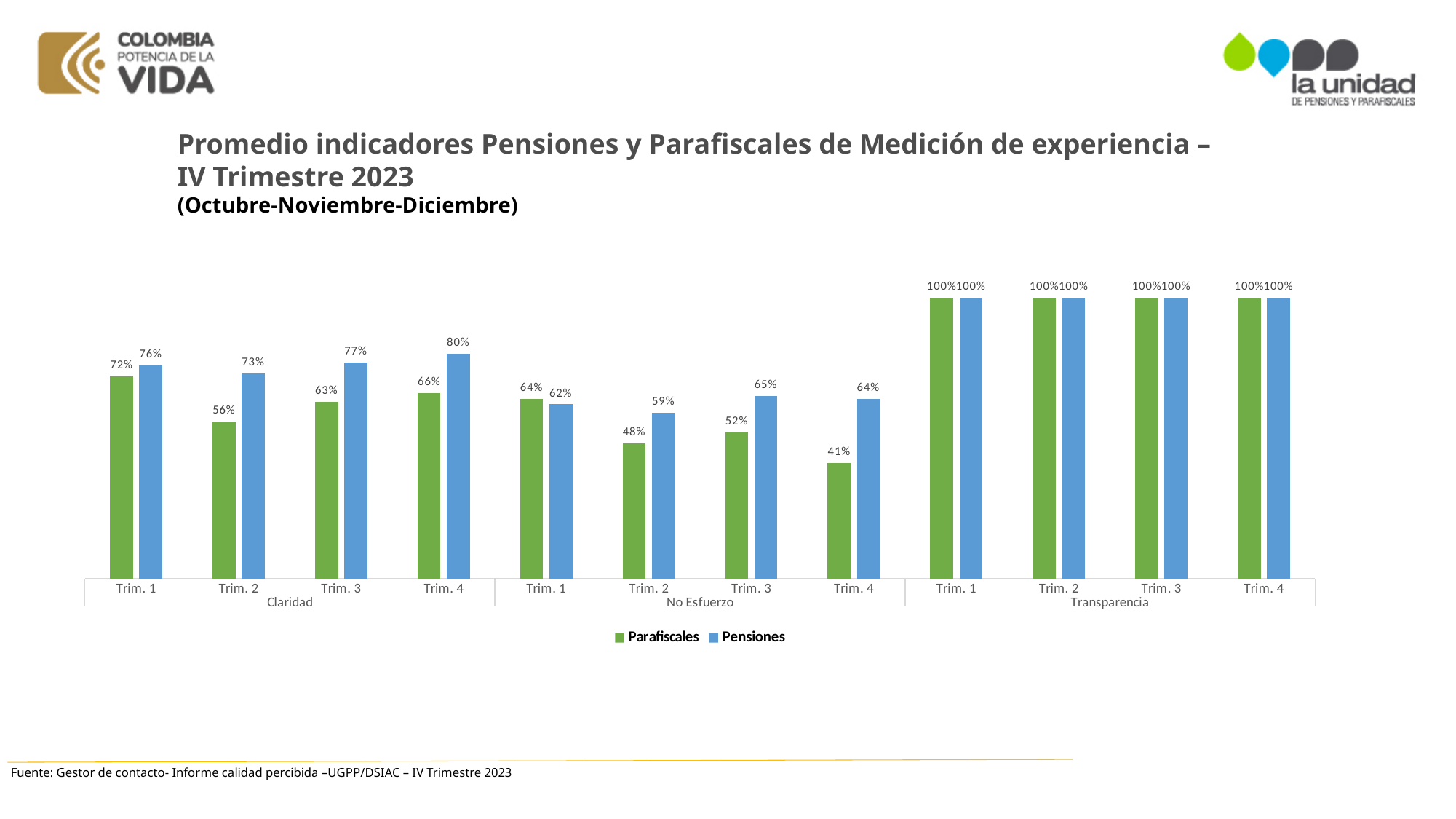
Which is larger for Trim. 1 under No Esfuerzo: Parafiscales or Pensiones? Parafiscales What is the Parafiscales value for Trim. 1 under Claridad? 72% What kind of chart is shown on the slide? Bar chart How many series does the legend list? 2 What is the Pensiones value for Trim. 2 under No Esfuerzo? 59% What is the difference between the Pensiones and Parafiscales values for Trim. 2 under Claridad? 17% Which quarter has the lowest Parafiscales value under No Esfuerzo? Trim. 4 What is the Pensiones value for Trim. 4 under Claridad? 80% Which colour represents the Pensiones series in the chart? Blue Which quarter has the highest Pensiones value under Claridad? Trim. 4 What is the Parafiscales value for Trim. 4 under No Esfuerzo? 41% What is the Parafiscales value for Trim. 3 under Transparencia? 100%